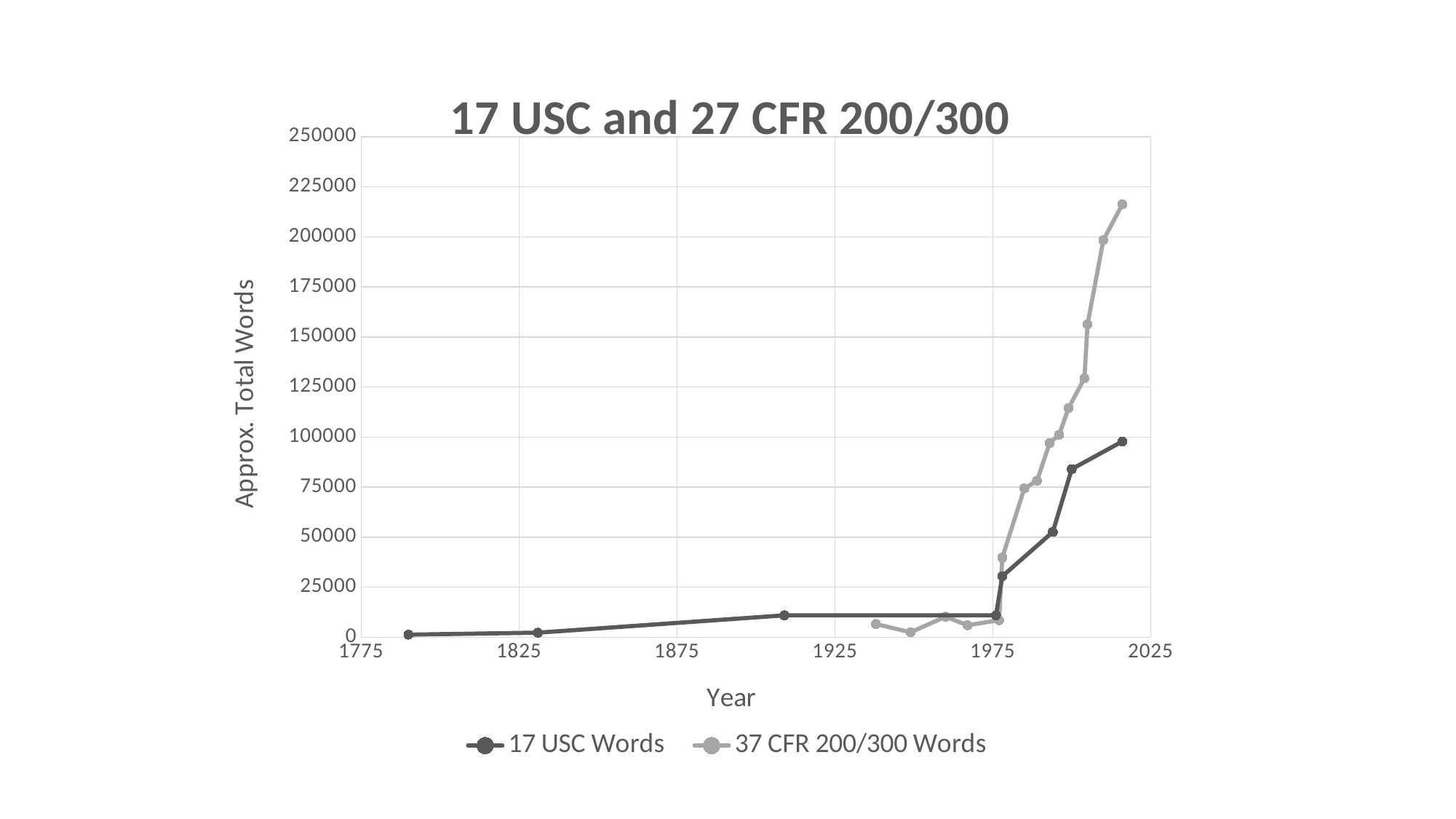
Which series reaches the highest value on the chart? 37 CFR 200/300 Words Is the final value of the 37 CFR 200/300 Words series greater or less than 200000? greater How many series does the legend list? 2 What kind of chart is shown on the slide? line chart Is the highest value of the 17 USC Words series greater or less than 125000? less What is the label of the vertical axis? Approx. Total Words Does the 17 USC Words series generally rise or fall from 1790 to the most recent year? rise What is the title of the chart? 17 USC and 27 CFR 200/300 Is the final value of the 17 USC Words series greater or less than 75000? greater At the right end of the chart, which series is higher: 17 USC Words or 37 CFR 200/300 Words? 37 CFR 200/300 Words